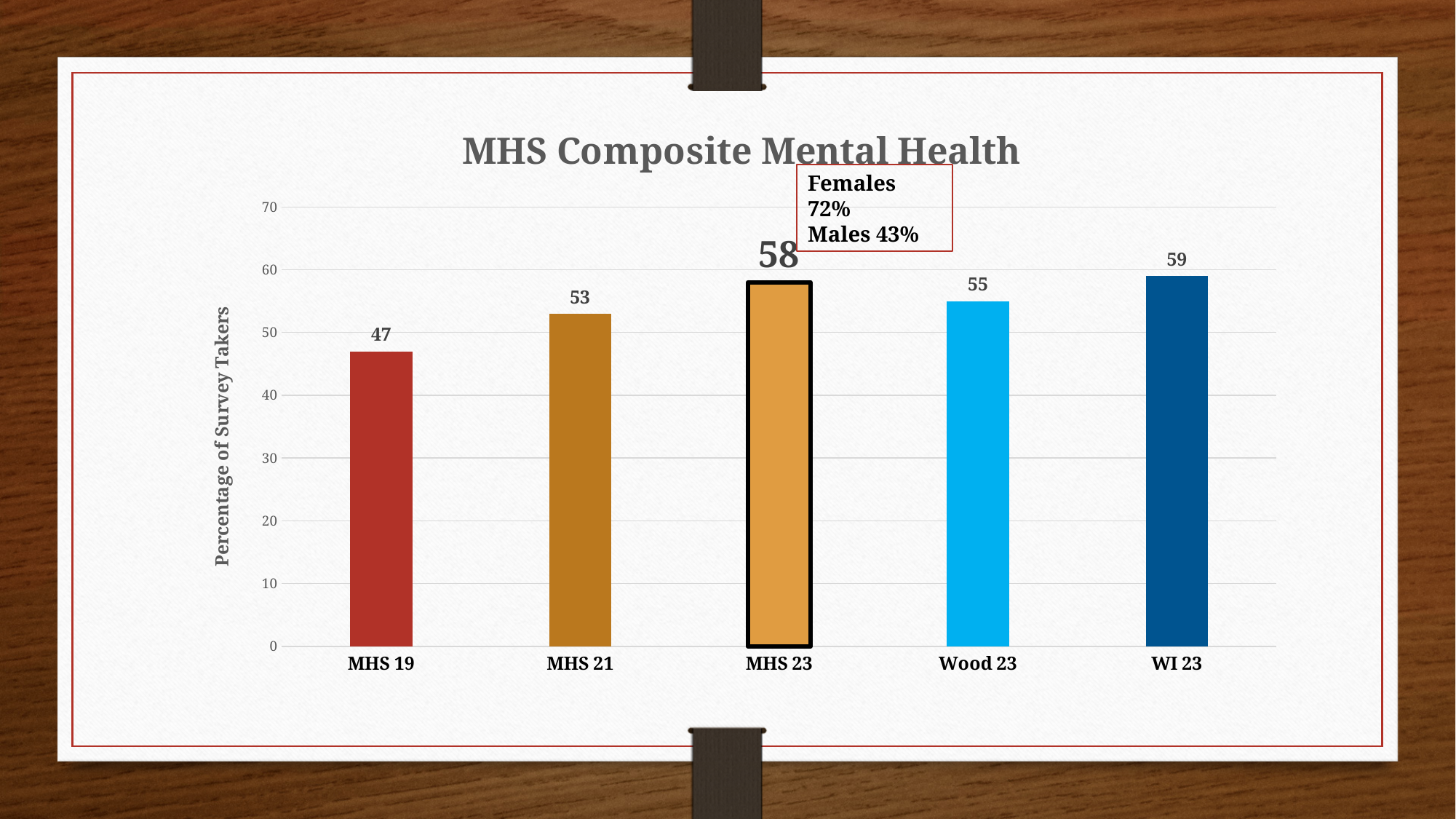
How many categories are shown on the x axis? 5 What is the value for Wood 23? 55 What is the difference between the values for WI 23 and Wood 23? 4 What is the difference between the values for MHS 23 and MHS 19? 11 What is the title of the chart? MHS Composite Mental Health What is the value for MHS 19? 47 Which category has the lowest value? MHS 19 Which is larger, the value for MHS 21 or the value for Wood 23? Wood 23 What kind of chart is shown on the slide? bar chart Is the value for MHS 21 greater or less than 50? greater Which category has the highest value? WI 23 What is the value for MHS 23? 58